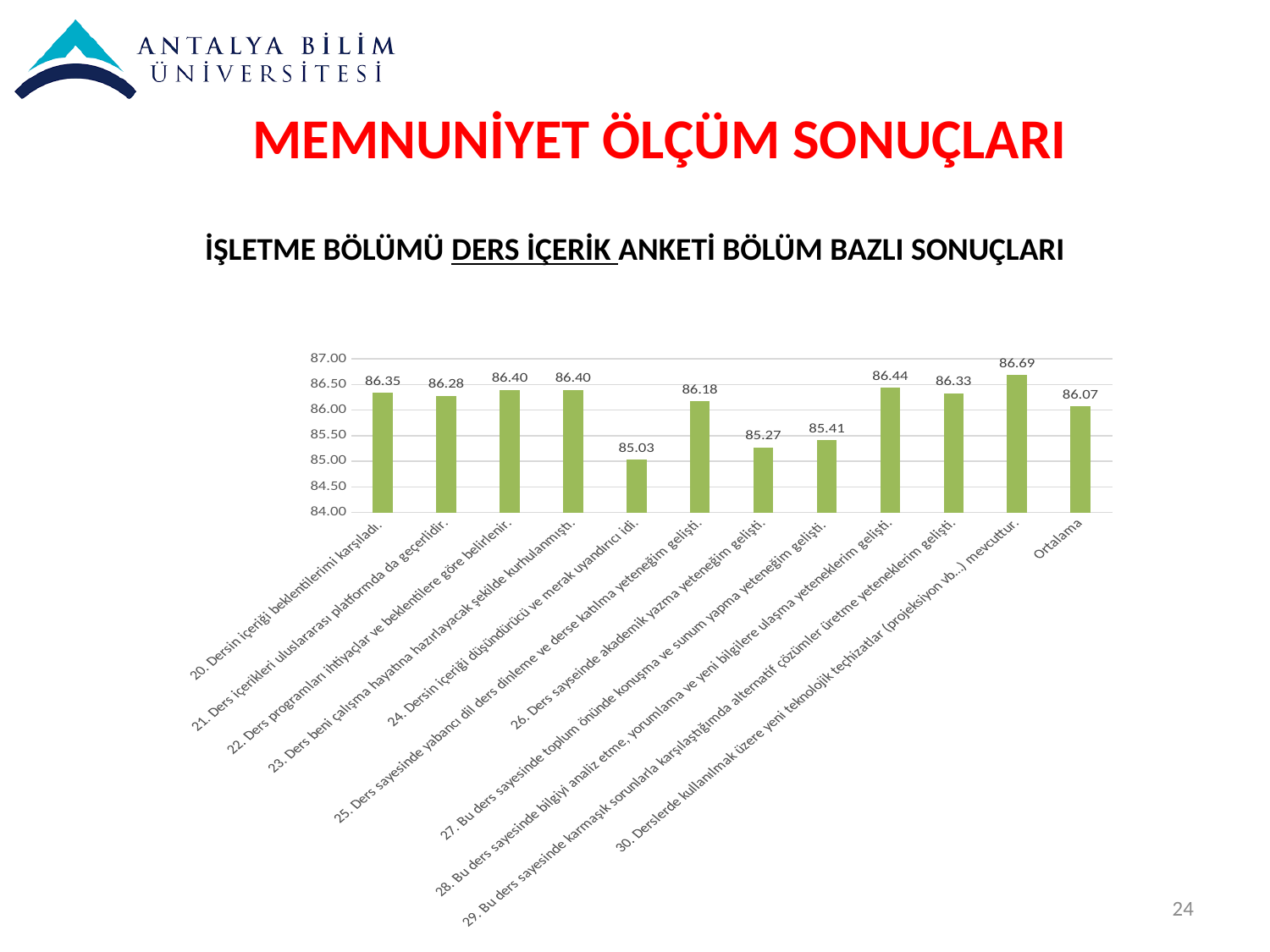
What is the value for item 26, "Ders sayesinde akademik yazma yeteneğim gelişti."? 85.27 What is the value for item 24, "Dersin içeriği düşündürücü ve merak uyandırıcı idi."? 85.03 What is the value for item 30, "Derslerde kullanılmak üzere yeni teknolojik teçhizatlar (projeksiyon vb...) mevcuttur."? 86.69 Which category has the highest value? 30. Derslerde kullanılmak üzere yeni teknolojik teçhizatlar (projeksiyon vb...) mevcuttur. What is the difference between the value for item 30 (86.69) and the value for item 24 (85.03)? 1.66 Which is larger: the value for item 27 (toplum önünde konuşma ve sunum yapma) or the value for item 28 (bilgiyi analiz etme, yorumlama)? item 28 (86.44) What is the value for "Ortalama"? 86.07 What kind of chart is shown on the slide? bar chart Is the value for item 25, "Ders sayesinde yabancı dil ders dinleme ve derse katılma yeteneğim gelişti.", greater or less than 86.00? greater What is the title text shown directly above the chart? İŞLETME BÖLÜMÜ DERS İÇERİK ANKETİ BÖLÜM BAZLI SONUÇLARI Which category has the lowest value? 24. Dersin içeriği düşündürücü ve merak uyandırıcı idi. How many bars (categories) are plotted in the chart? 12